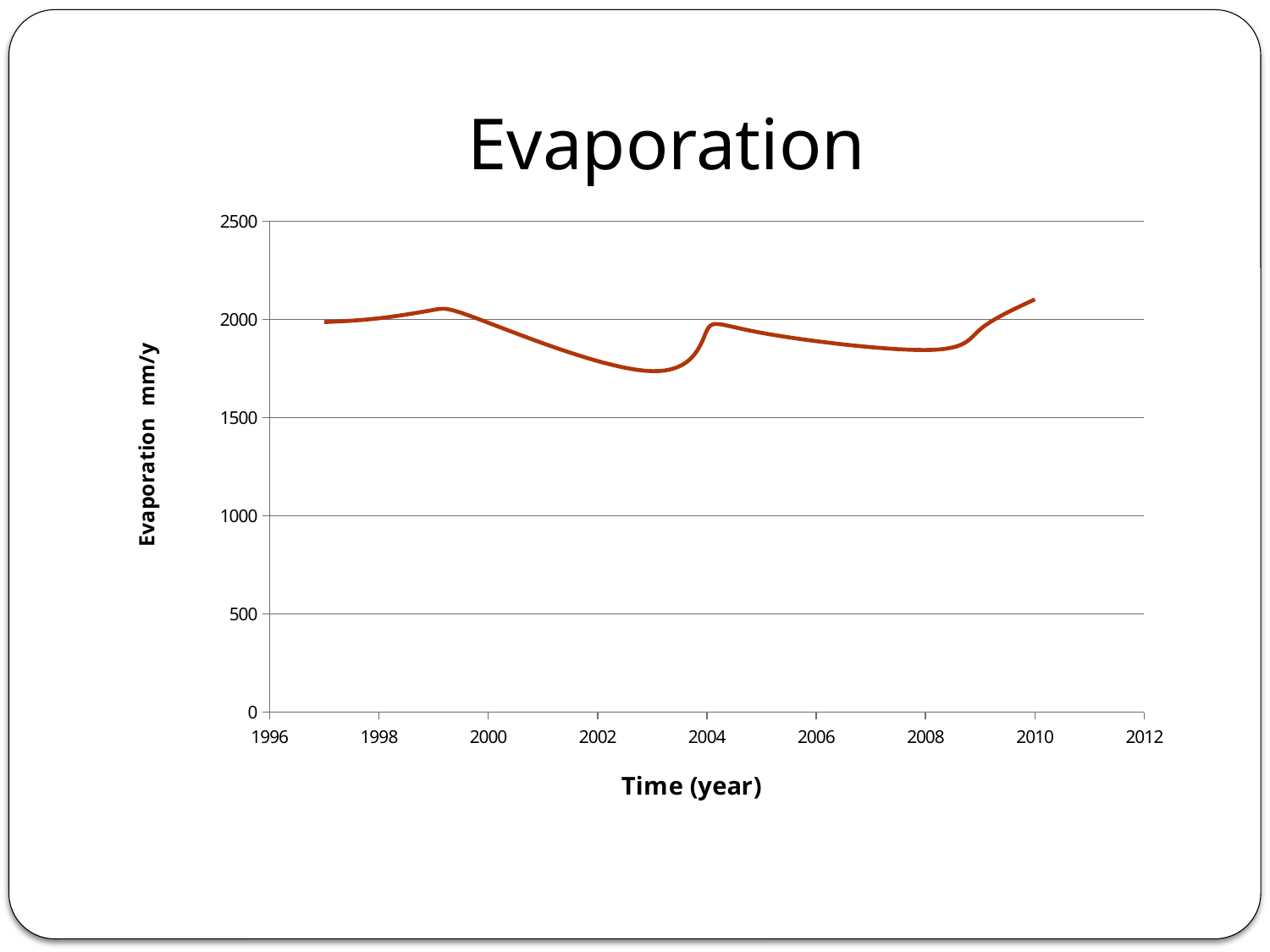
Which year has the higher evaporation value, 2003 or 2010? 2010 In which year does the line reach its lowest value? 2003 Is the evaporation value for 2003 greater or less than 2000? less Does the evaporation value rise or fall between 1999 and 2003? fall Is the evaporation value for 2008 greater or less than 2000? less Does the evaporation value rise or fall between 2008 and 2010? rise What kind of chart is shown on the slide? line chart Is the evaporation value for 2003 greater or less than 1500? greater What is the title of the chart? Evaporation What is the label of the x axis? Time (year)